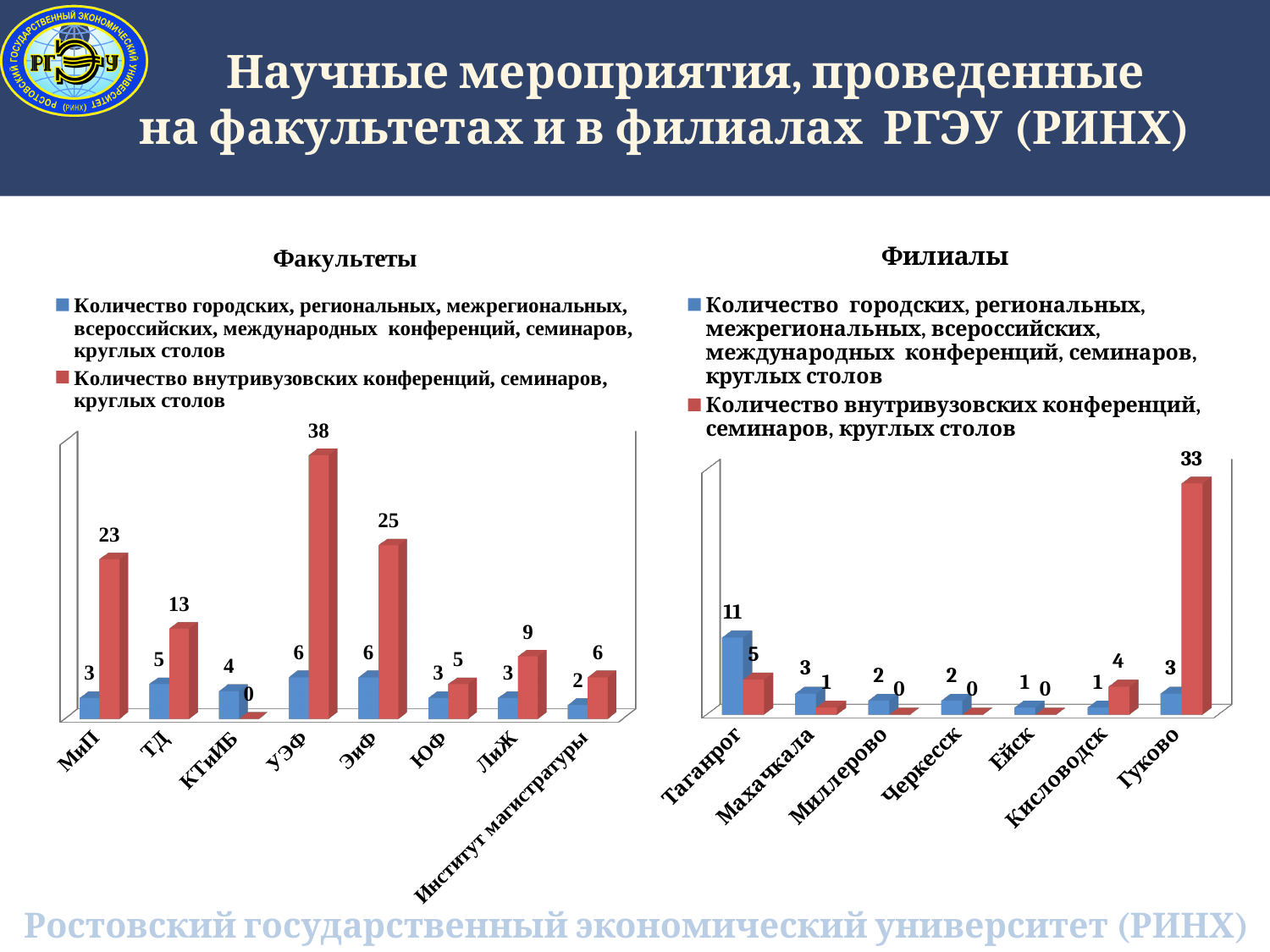
In the 'Факультеты' chart, what is the value of 'Количество городских, региональных, межрегиональных, всероссийских, международных конференций, семинаров, круглых столов' for ТД? 5 How many categories are shown on the x axis of the 'Факультеты' chart? 8 In the 'Факультеты' chart, which category has the highest value for 'Количество внутривузовских конференций, семинаров, круглых столов'? УЭФ In the 'Факультеты' chart, which category has the lowest value for 'Количество внутривузовских конференций, семинаров, круглых столов'? КТиИБ In the 'Филиалы' chart, which is larger for Кисловодск: the blue series or the red series? the red series In the 'Факультеты' chart, what is the difference between the 'Количество внутривузовских конференций, семинаров, круглых столов' values for УЭФ and ЭиФ? 13 What type of chart is the 'Филиалы' chart? bar chart In the 'Филиалы' chart, which category has the highest value for 'Количество городских, региональных, межрегиональных, всероссийских, международных конференций, семинаров, круглых столов'? Таганрог In the 'Филиалы' chart, what is the value of 'Количество городских, региональных, межрегиональных, всероссийских, международных конференций, семинаров, круглых столов' for Таганрог? 11 How many categories are shown on the x axis of the 'Филиалы' chart? 7 In the 'Филиалы' chart, what is the value of 'Количество внутривузовских конференций, семинаров, круглых столов' for Гуково? 33 In the 'Факультеты' chart, what is the value of 'Количество внутривузовских конференций, семинаров, круглых столов' for УЭФ? 38